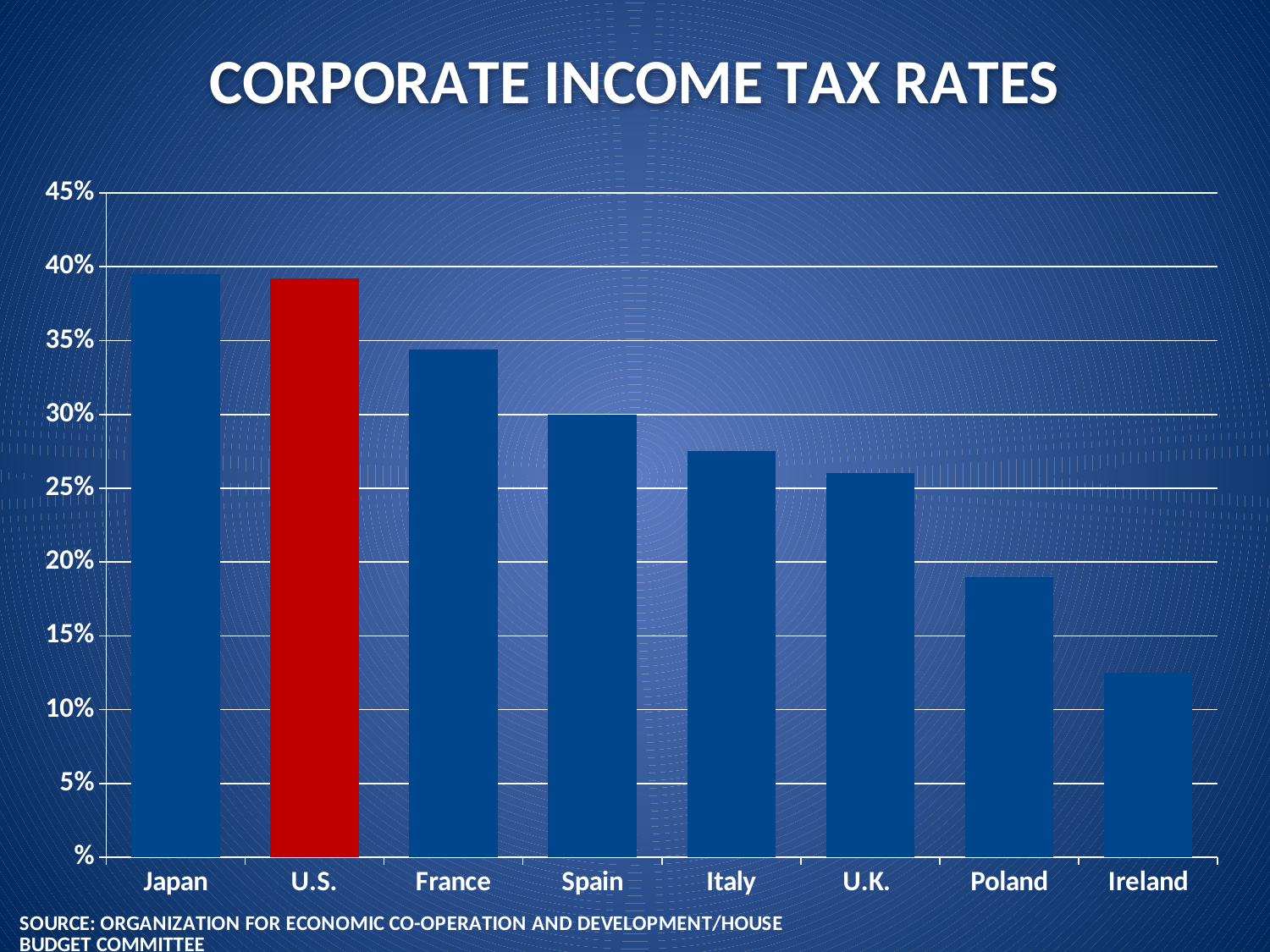
Which has a higher corporate income tax rate, France or the U.K.? France Is the value for Poland greater or less than 20%? less Is the value for France greater or less than 30%? greater Do the values rise or fall moving from left to right across the chart? fall What kind of chart is shown on the slide? bar chart Is the value for France greater or less than 35%? less Which country's bar is coloured red? U.S. How many countries are shown on the chart? 8 Which has a higher corporate income tax rate, Poland or Ireland? Poland Which country has the lowest corporate income tax rate on the chart? Ireland